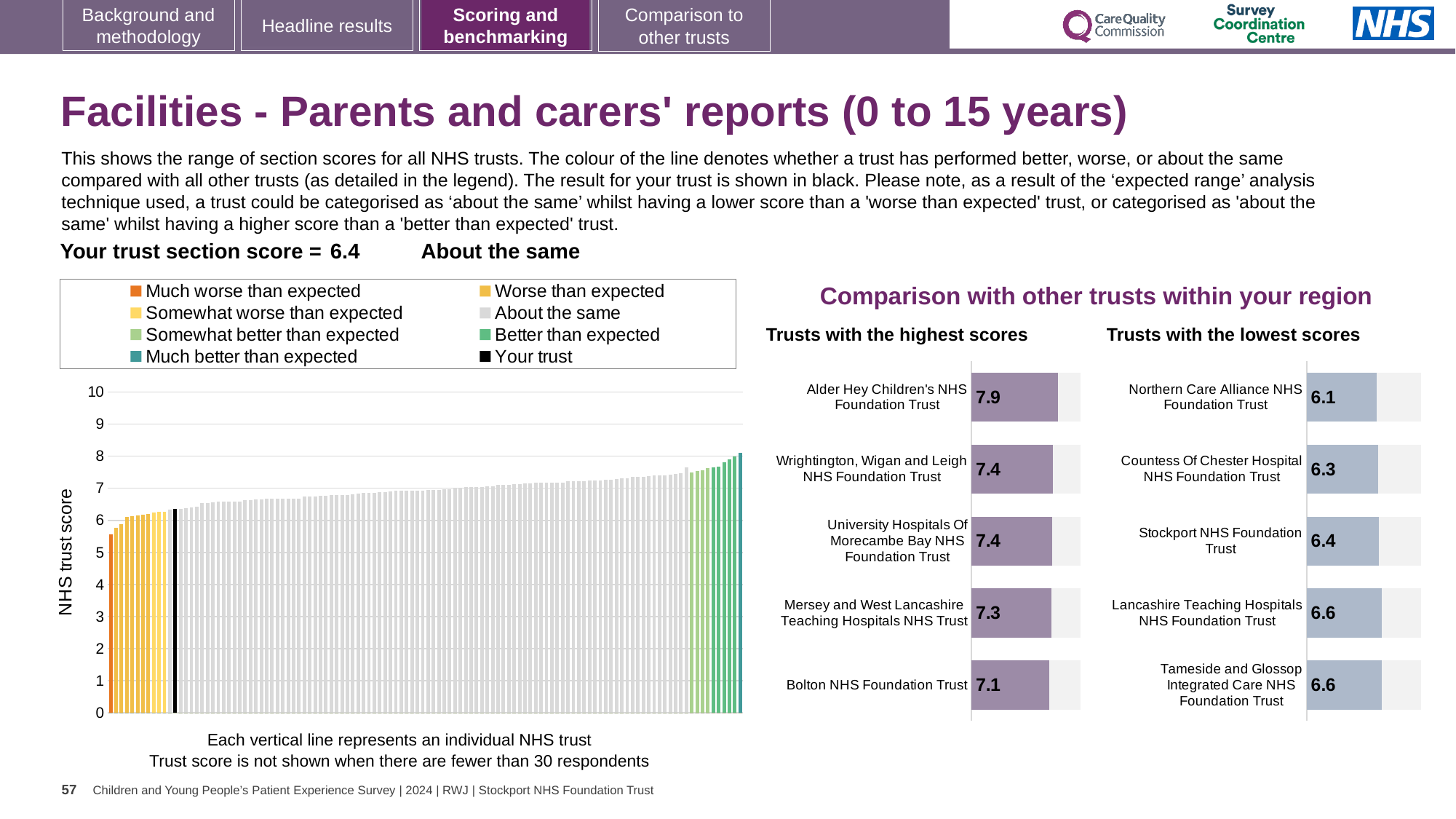
In the left-hand chart, do the trust scores rise or fall from left to right? Rise In the 'Trusts with the lowest scores' chart, which has the higher score: Stockport NHS Foundation Trust or Countess Of Chester Hospital NHS Foundation Trust? Stockport NHS Foundation Trust In the 'Trusts with the highest scores' chart, how many trusts are listed? 5 What kind of chart is the large chart on the left showing NHS trust scores? Bar chart How many entries does the legend of the left-hand chart list? 8 In the left-hand chart, is the value of the lowest (leftmost) bar greater or less than 6? less In the 'Trusts with the highest scores' chart, which trust has the lowest score shown? Bolton NHS Foundation Trust In the 'Trusts with the highest scores' chart, what is the score for Alder Hey Children's NHS Foundation Trust? 7.9 In the 'Trusts with the lowest scores' chart, what is the difference between the scores of Tameside and Glossop Integrated Care NHS Foundation Trust and Northern Care Alliance NHS Foundation Trust? 0.5 In the 'Trusts with the lowest scores' chart, what is the score for Northern Care Alliance NHS Foundation Trust? 6.1 In the 'Trusts with the highest scores' chart, what is the difference between the scores of Alder Hey Children's NHS Foundation Trust and Bolton NHS Foundation Trust? 0.8 In the 'Trusts with the lowest scores' chart, which trust has the lowest score? Northern Care Alliance NHS Foundation Trust